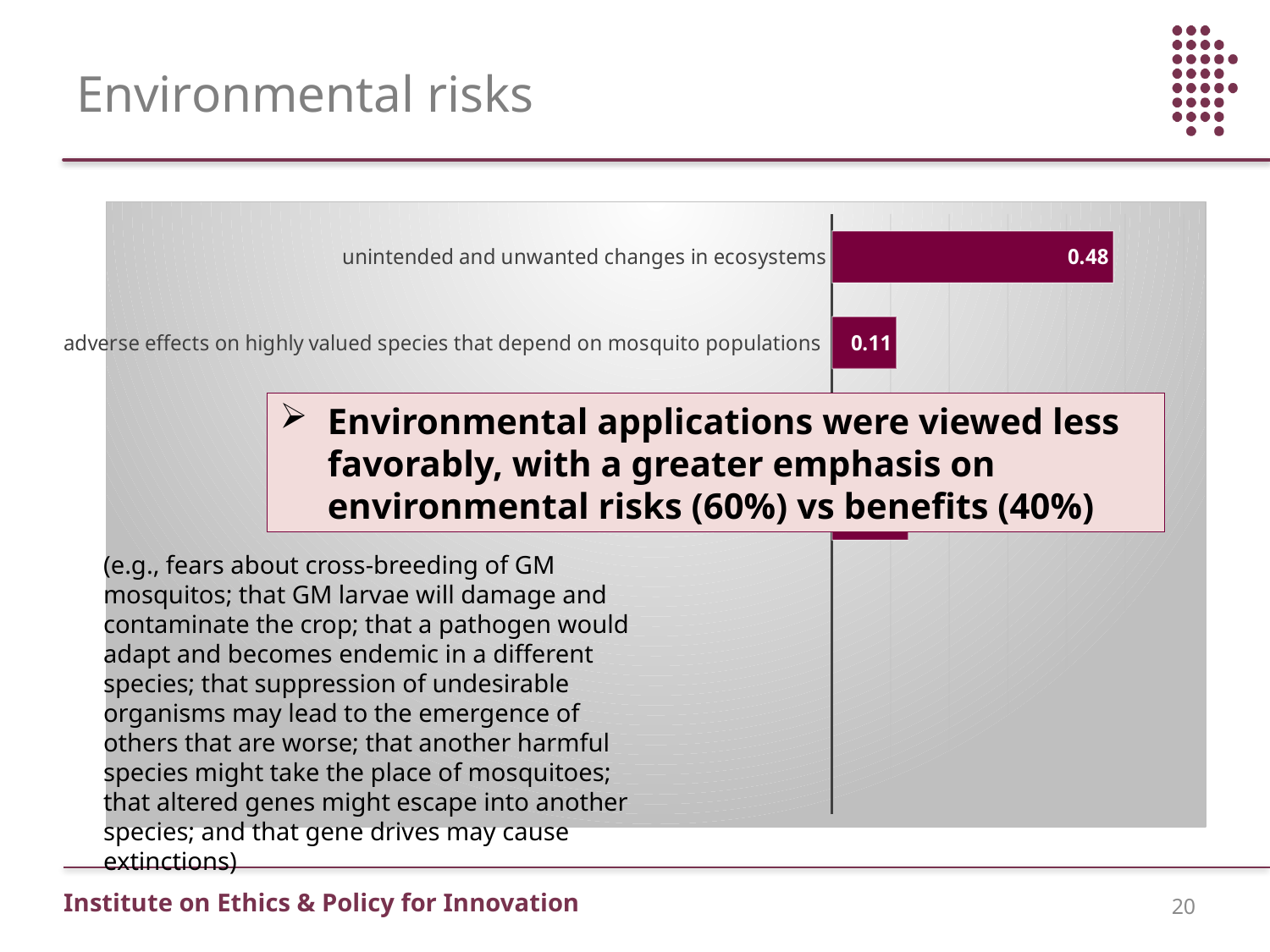
Which category has the highest value in the chart? unintended and unwanted changes in ecosystems What is the difference between the values for "unintended and unwanted changes in ecosystems" and "adverse effects on highly valued species that depend on mosquito populations"? 0.37 What is the title of the slide containing the chart? Environmental risks What is the value for "adverse effects on highly valued species that depend on mosquito populations"? 0.11 What is the value for "unintended and unwanted changes in ecosystems"? 0.48 Which has the larger value: "unintended and unwanted changes in ecosystems" or "adverse effects on highly valued species that depend on mosquito populations"? unintended and unwanted changes in ecosystems Are the bars in the chart drawn horizontally or vertically? horizontally What kind of chart is shown on the slide? bar chart